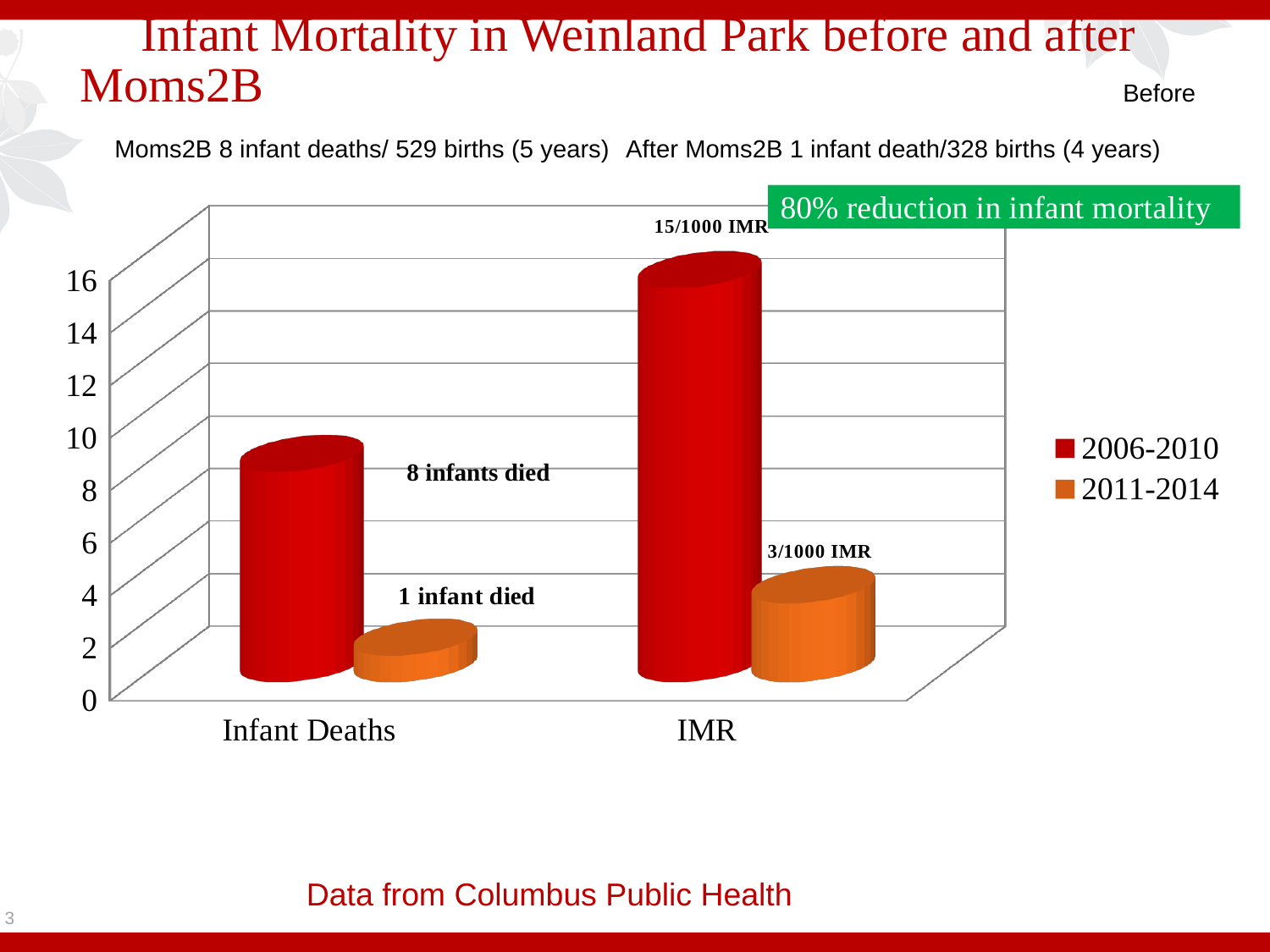
Which bar is the tallest in the chart? IMR, 2006-2010 What is the IMR labelled for 2006-2010? 15/1000 IMR Is the 2006-2010 IMR bar greater or less than 14? greater What are the two series named in the legend? 2006-2010 and 2011-2014 Which is larger, the 2006-2010 Infant Deaths bar or the 2011-2014 IMR bar? 2006-2010 Infant Deaths How many series does the legend list? 2 What kind of chart is shown on the slide? bar chart According to the label on the chart, how many infants died in 2011-2014? 1 infant died Which bar is the shortest in the chart? Infant Deaths, 2011-2014 According to the label on the chart, how many infants died in 2006-2010? 8 infants died How many categories are shown on the x axis? 2 What is the IMR labelled for 2011-2014? 3/1000 IMR